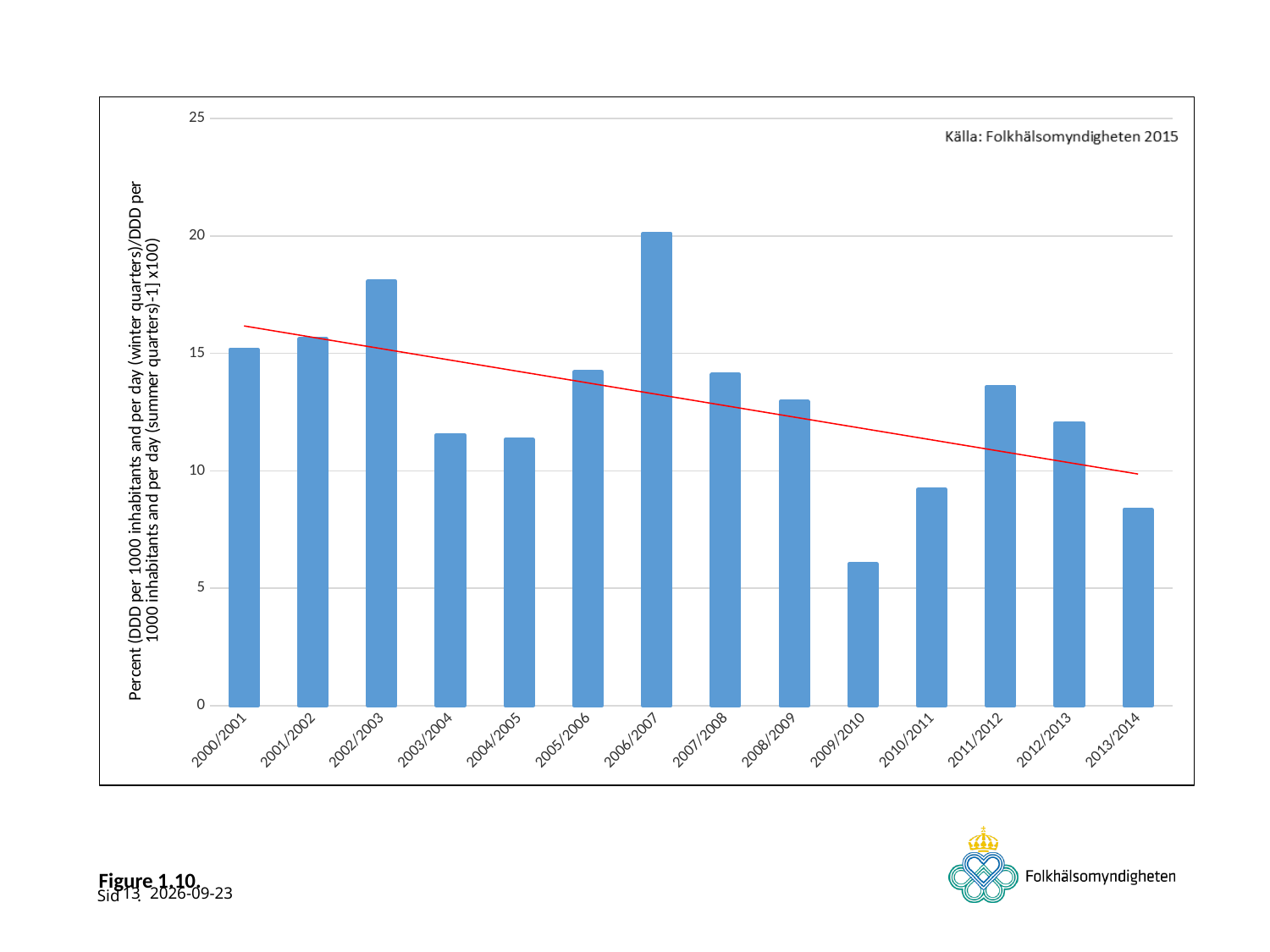
Which period has the highest bar? 2006/2007 Which is larger, the value for 2002/2003 or the value for 2006/2007? 2006/2007 Which is larger, the value for 2009/2010 or the value for 2013/2014? 2013/2014 What source is cited in the top right corner of the chart? Källa: Folkhälsomyndigheten 2015 Is the value for 2002/2003 greater or less than 15? greater How many winter/summer periods (bars) are plotted on the chart? 14 According to the red trend line, do the values generally rise or fall from 2000/2001 to 2013/2014? Fall Is the value for 2009/2010 greater or less than 10? less Is the value for 2003/2004 greater or less than 10? greater Which period has the lowest bar? 2009/2010 What kind of chart is shown on the slide? Bar chart